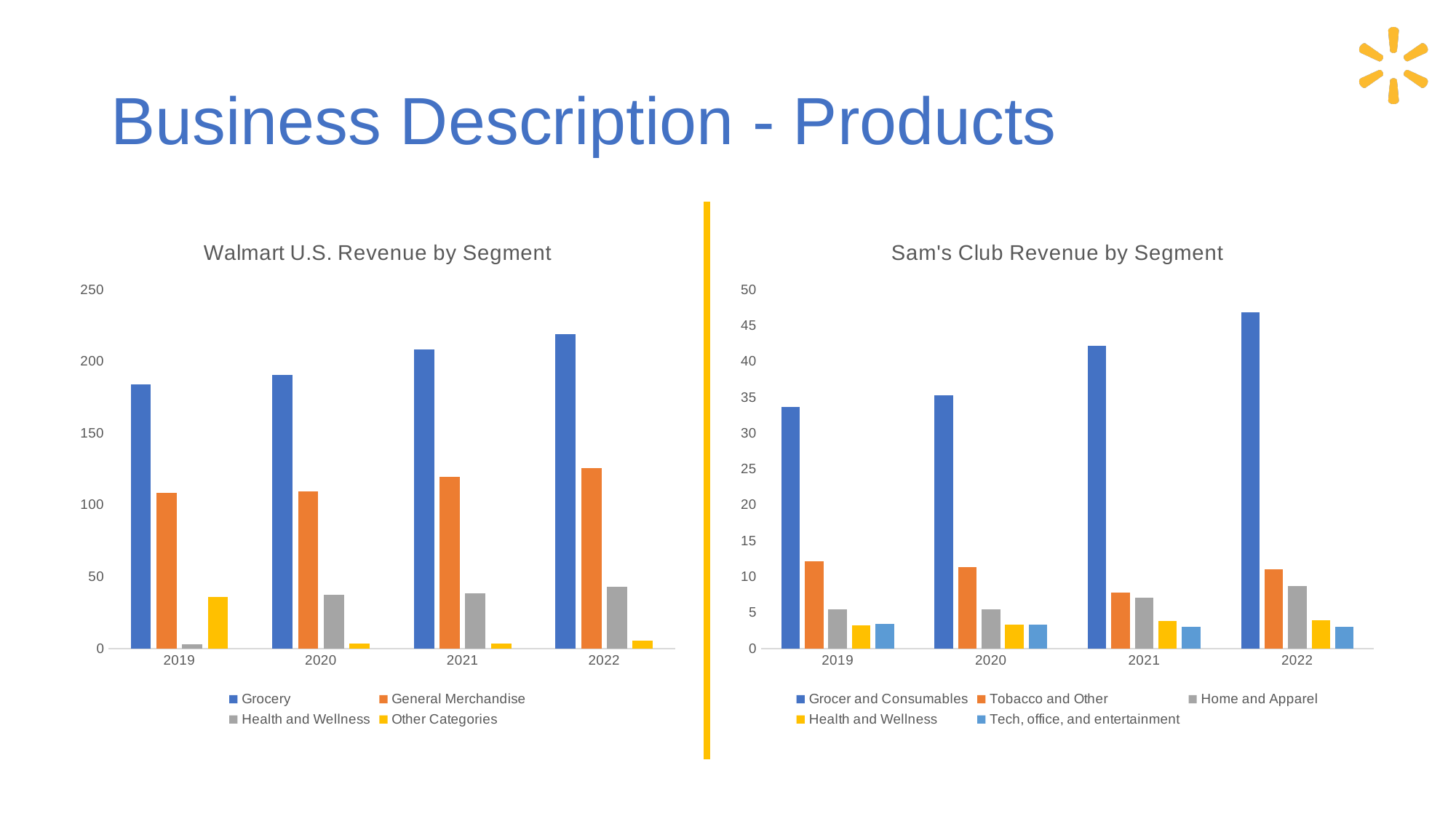
In the Walmart U.S. Revenue by Segment chart, do the Grocery values rise or fall from 2019 to 2022? rise How many years are shown on the x axis of the Walmart U.S. Revenue by Segment chart? 4 How many series does the legend of the Sam's Club Revenue by Segment chart list? 5 In the Walmart U.S. Revenue by Segment chart, is the Grocery value for 2022 greater or less than 200? greater In the Sam's Club Revenue by Segment chart, is the Grocer and Consumables value for 2022 greater or less than 45? greater In the Walmart U.S. Revenue by Segment chart, is the General Merchandise value for 2021 greater or less than 100? greater In the Sam's Club Revenue by Segment chart, which segment has the highest value in 2021? Grocer and Consumables What kind of chart is the Walmart U.S. Revenue by Segment chart? bar chart In the Walmart U.S. Revenue by Segment chart, which year has the highest Grocery value? 2022 In the Sam's Club Revenue by Segment chart, which is larger in 2019: Tobacco and Other or Home and Apparel? Tobacco and Other How many series does the legend of the Walmart U.S. Revenue by Segment chart list? 4